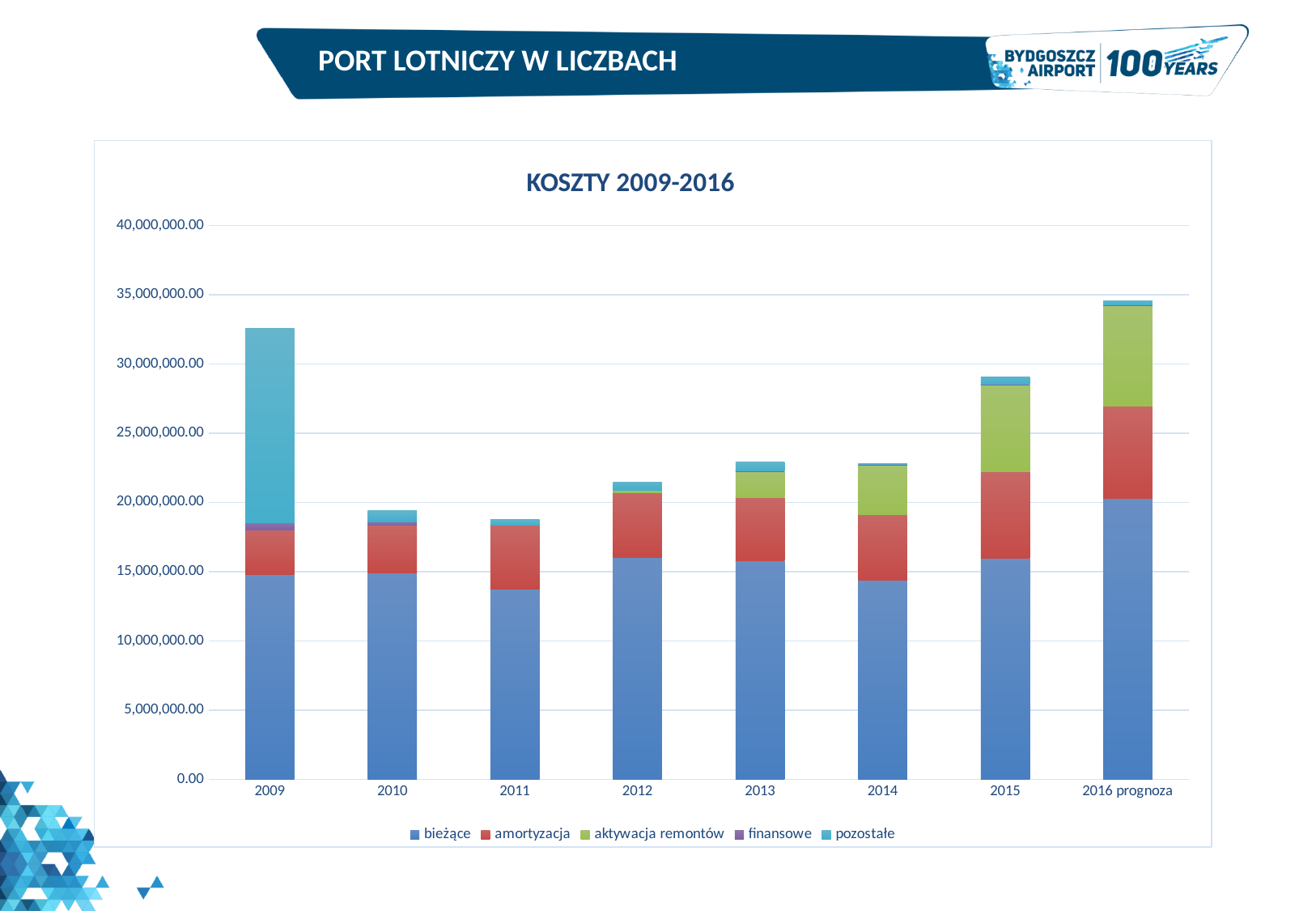
How many categories (years) are shown on the x axis? 8 How many series does the legend list? 5 Which category has the tallest stacked bar overall? 2016 prognoza Do the total bar heights rise or fall from 2011 to 2016 prognoza? rise Is the total for 2015 greater or less than 30,000,000.00? less Which has the larger total bar, 2014 or 2015? 2015 What type of chart is shown on the slide? stacked bar chart What is the title of the chart? KOSZTY 2009-2016 Which series is shown in green in the legend? aktywacja remontów Is the total for 2012 greater or less than 20,000,000.00? greater Is the total for 2009 greater or less than 30,000,000.00? greater